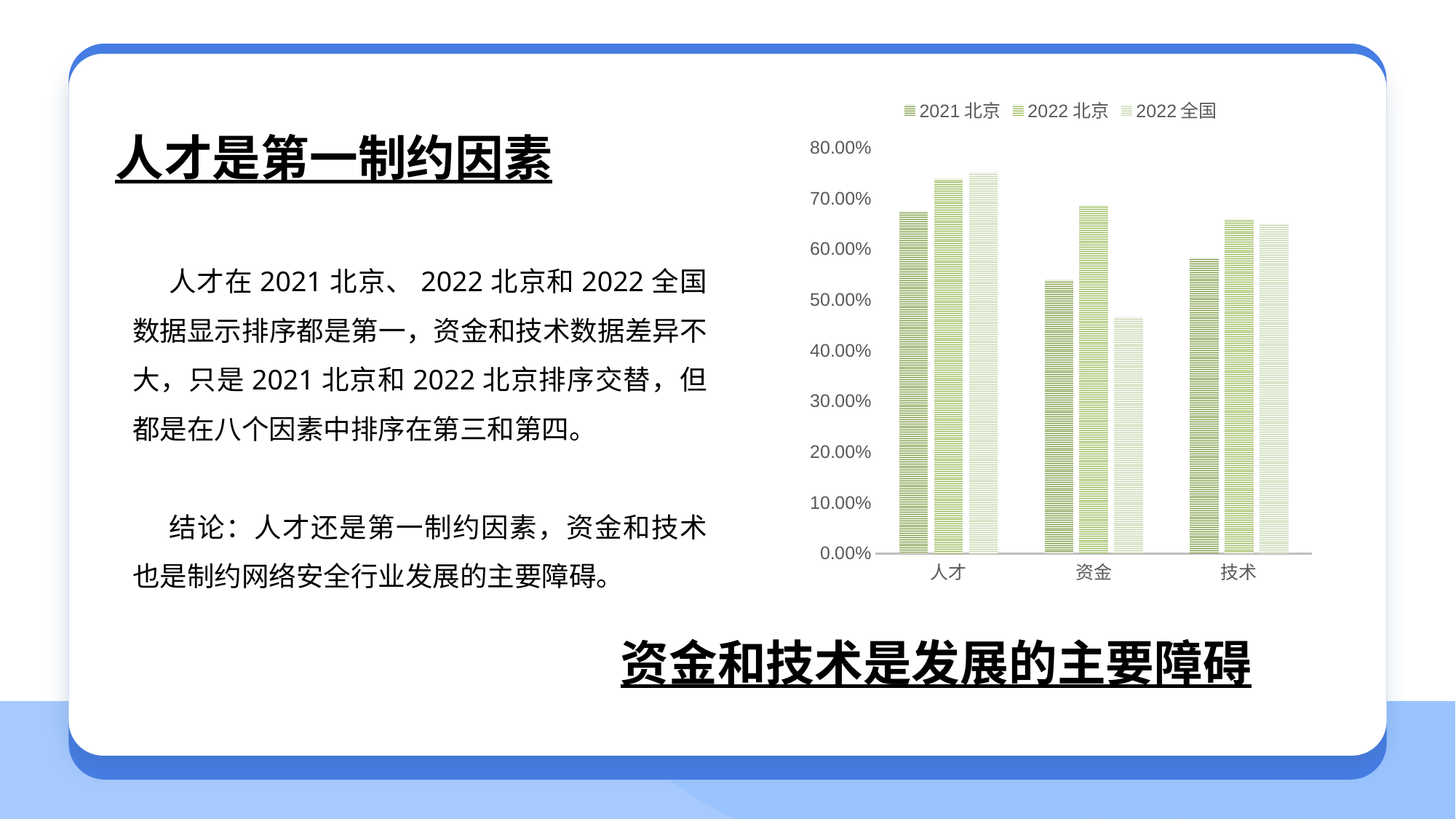
How many series does the chart's legend list? 3 How many categories are shown on the x axis of the chart? 3 What kind of chart is shown on the slide? bar chart In the 人才 category, which is larger: the 2021 北京 value or the 2022 北京 value? 2022 北京 Is the value for 2021 北京 in the 技术 category greater or less than 60.00%? less Which category has the lowest value for the 2022 全国 series? 资金 Which category has the lowest value for the 2021 北京 series? 资金 Is the value for 2022 全国 in the 资金 category greater or less than 50.00%? less In the 资金 category, which is larger: the 2022 北京 value or the 2022 全国 value? 2022 北京 What is the highest value shown on the chart's vertical axis? 80.00% Is the value for 2022 北京 in the 人才 category greater or less than 70.00%? greater Which category has the highest value for the 2022 全国 series? 人才